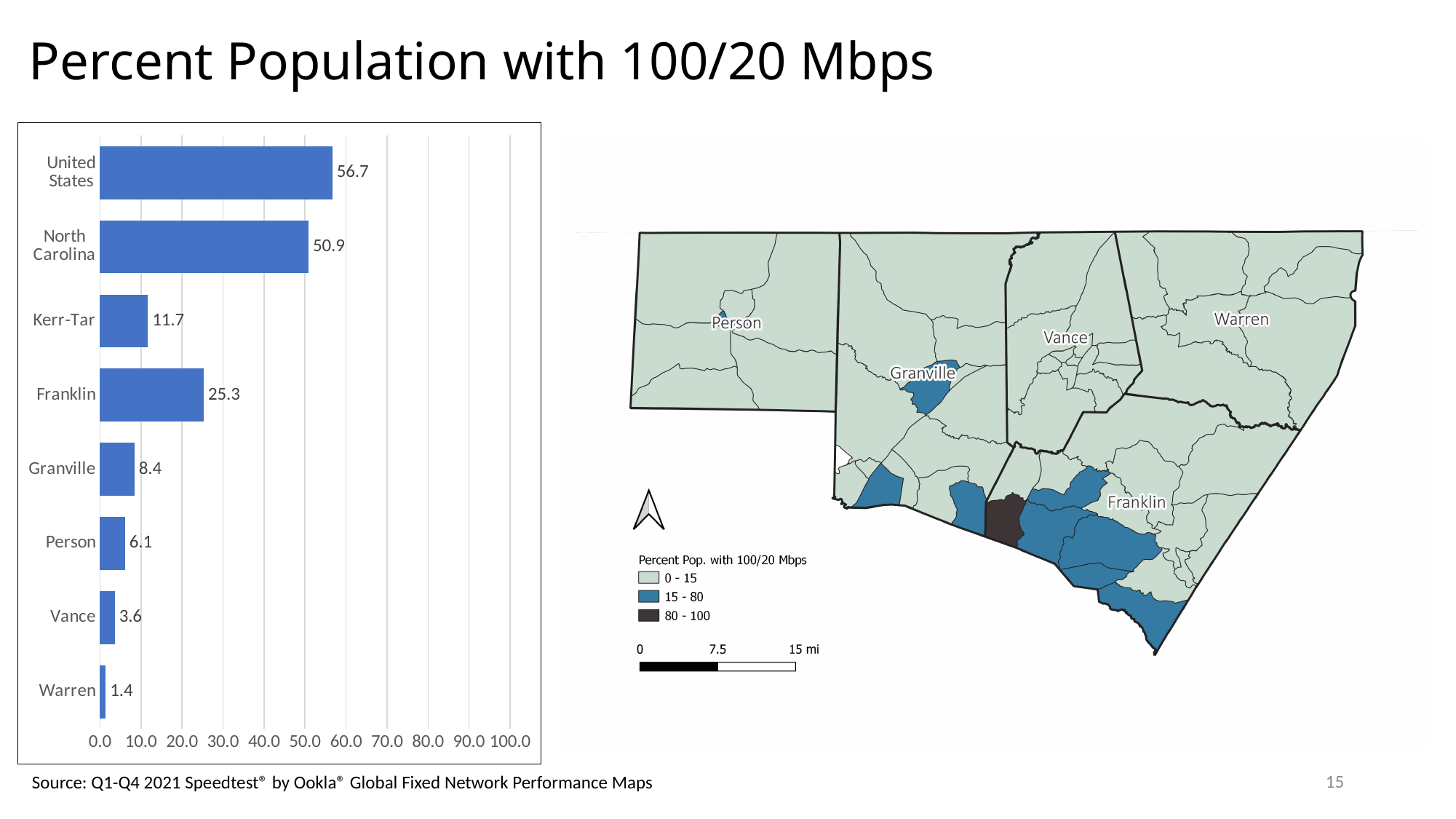
What kind of chart is shown on the left of the slide? Bar chart What is the value for Vance in the bar chart? 3.6 Which category has the lowest value in the bar chart? Warren What is the maximum value shown on the x axis of the bar chart? 100.0 What is the difference between the values for United States and North Carolina in the bar chart? 5.8 What is the difference between the values for Franklin and Granville in the bar chart? 16.9 What is the value for Kerr-Tar in the bar chart? 11.7 Which has a larger value in the bar chart, Person or Granville? Granville What is the value for Franklin in the bar chart? 25.3 Which category has the highest value in the bar chart? United States Is the value for North Carolina in the bar chart greater or less than 50.0? greater How many categories are shown in the bar chart? 8